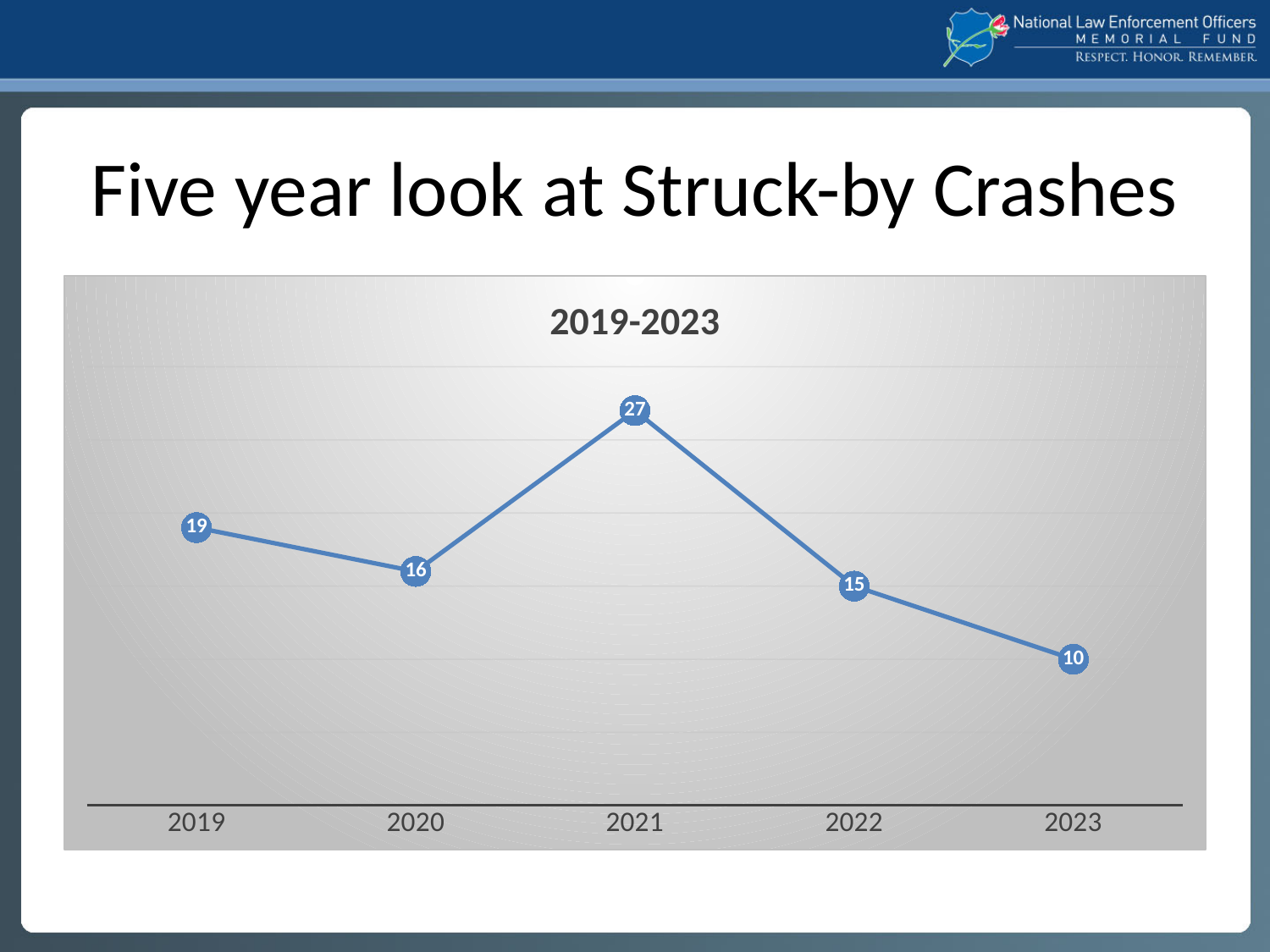
What is the value for 2023? 10 What is the difference between the values for 2019 and 2023? 9 How many years are plotted on the chart? 5 Do the values rise or fall from 2021 to 2023? fall Which year has the lowest value? 2023 What is the value for 2019? 19 What kind of chart is shown? line chart Which year has the highest value? 2021 What is the difference between the values for 2021 and 2020? 11 What is the title shown inside the chart area? 2019-2023 Which is larger, the value for 2020 or the value for 2022? 2020 What is the value for 2021? 27